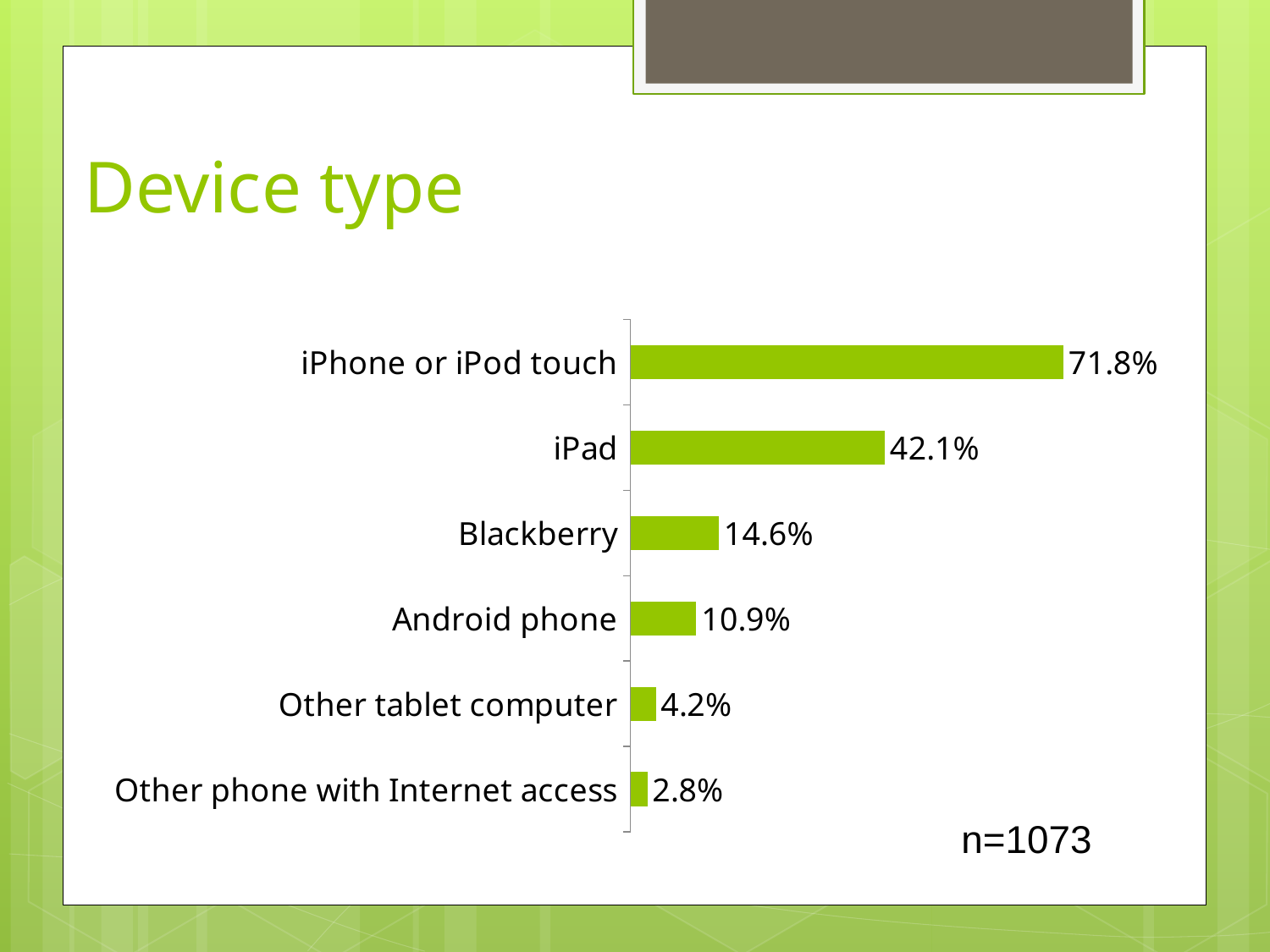
What kind of chart is shown on the slide? Bar chart Which is larger, the value for Blackberry or the value for Android phone? Blackberry How many device types are shown in the chart? 6 What sample size (n) is shown on the slide? n=1073 Which device type has the highest value? iPhone or iPod touch What is the difference between the values for iPhone or iPod touch and iPad? 29.7% What is the value for Android phone? 10.9% What is the value for Blackberry? 14.6% What is the value for Other phone with Internet access? 2.8% Which device type has the lowest value? Other phone with Internet access What is the value for iPad? 42.1% What is the value for iPhone or iPod touch? 71.8%